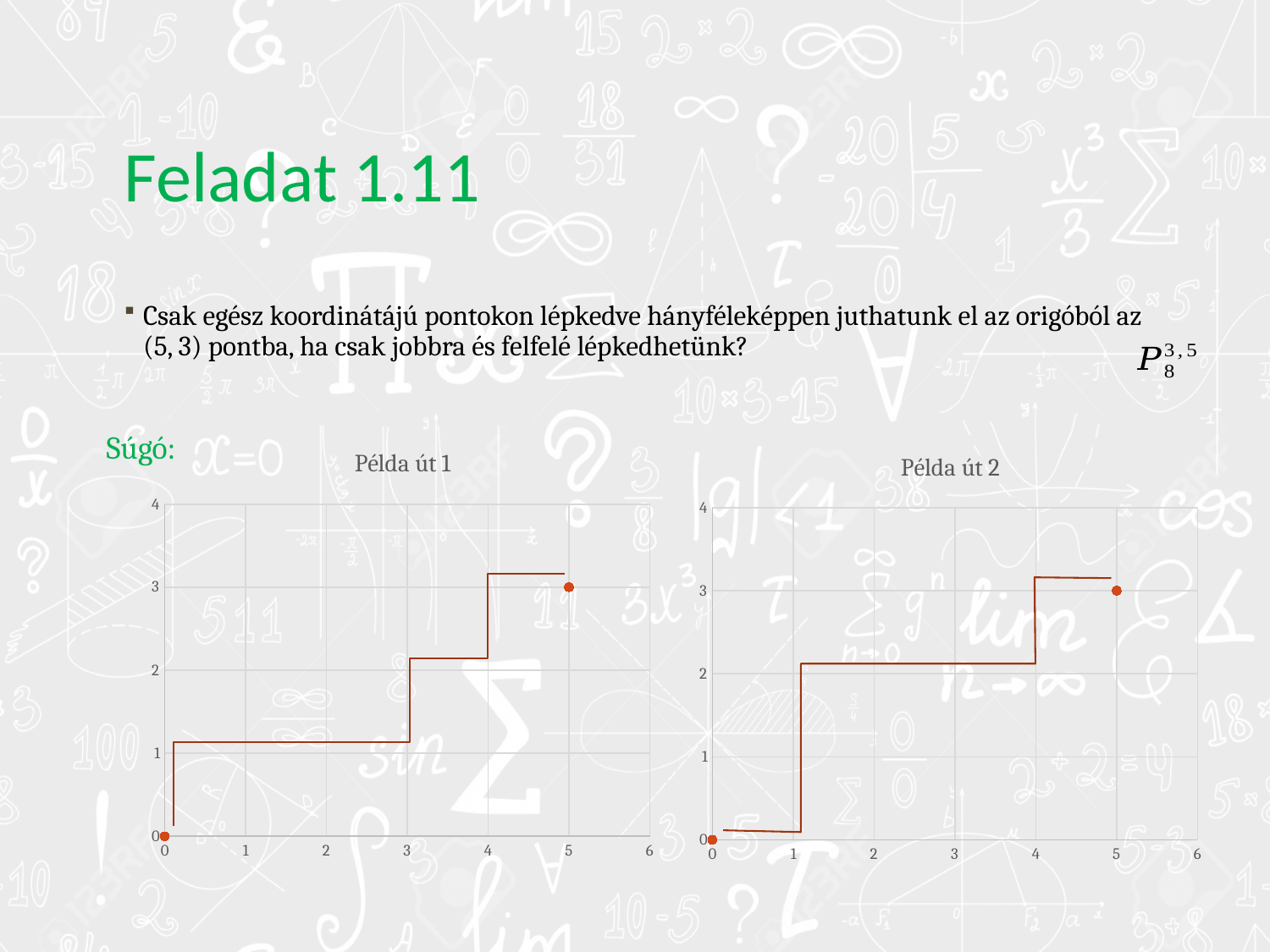
What is the title of the chart on the right side of the slide? Példa út 2 In "Példa út 2", how many points are marked with dots? 2 In "Példa út 2", which is larger: the path value at x = 3 or at x = 4.5? x = 4.5 What is the highest tick value shown on the y axis of "Példa út 1"? 4 In "Példa út 2", is the value of the path at x = 2 greater or less than 1? greater In "Példa út 1", what is the difference between the y value at x = 5 and the y value at x = 0? 3 In "Példa út 1", what is the y value of the marked end point at x = 5? 3 What kind of chart is "Példa út 1"? line chart In "Példa út 2", what is the y value of the marked point at x = 0? 0 How many charts are shown on the slide? 2 In "Példa út 1", is the value of the path at x = 2 greater or less than 2? less In "Példa út 1", does the path rise or fall as x increases? rises